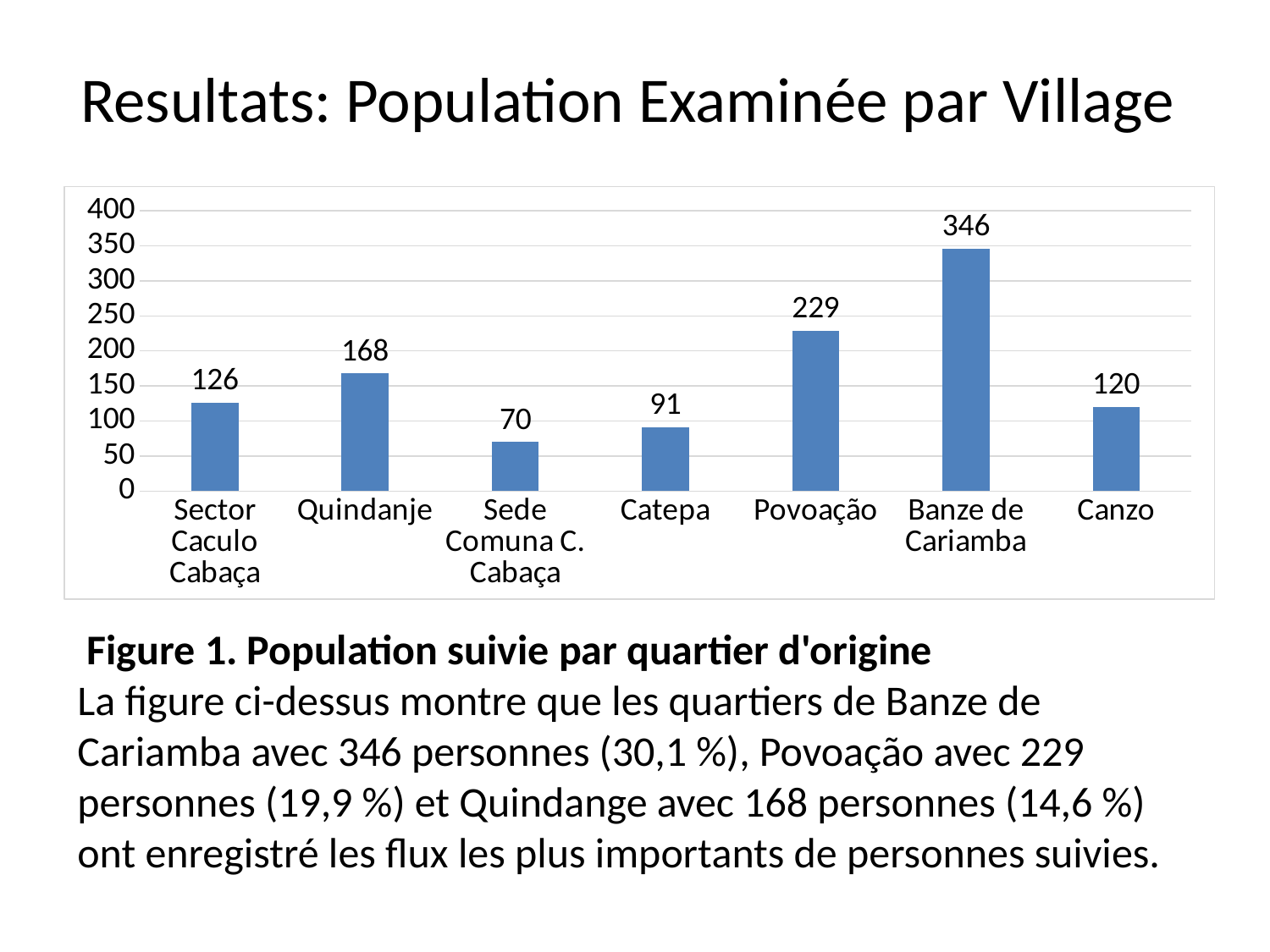
What is the value for Banze de Cariamba? 346 How many categories are shown on the x axis? 7 Which category has the highest value? Banze de Cariamba What is the value for Sede Comuna C. Cabaça? 70 Is the value for Quindanje greater or less than 150? greater Which category has the lowest value? Sede Comuna C. Cabaça Which is larger, the value for Sector Caculo Cabaça or the value for Canzo? Sector Caculo Cabaça What is the difference between the values for Quindanje and Sector Caculo Cabaça? 42 What is the difference between the values for Banze de Cariamba and Povoação? 117 What kind of chart is shown on the slide? bar chart What is the value for Catepa? 91 What is the value for Canzo? 120